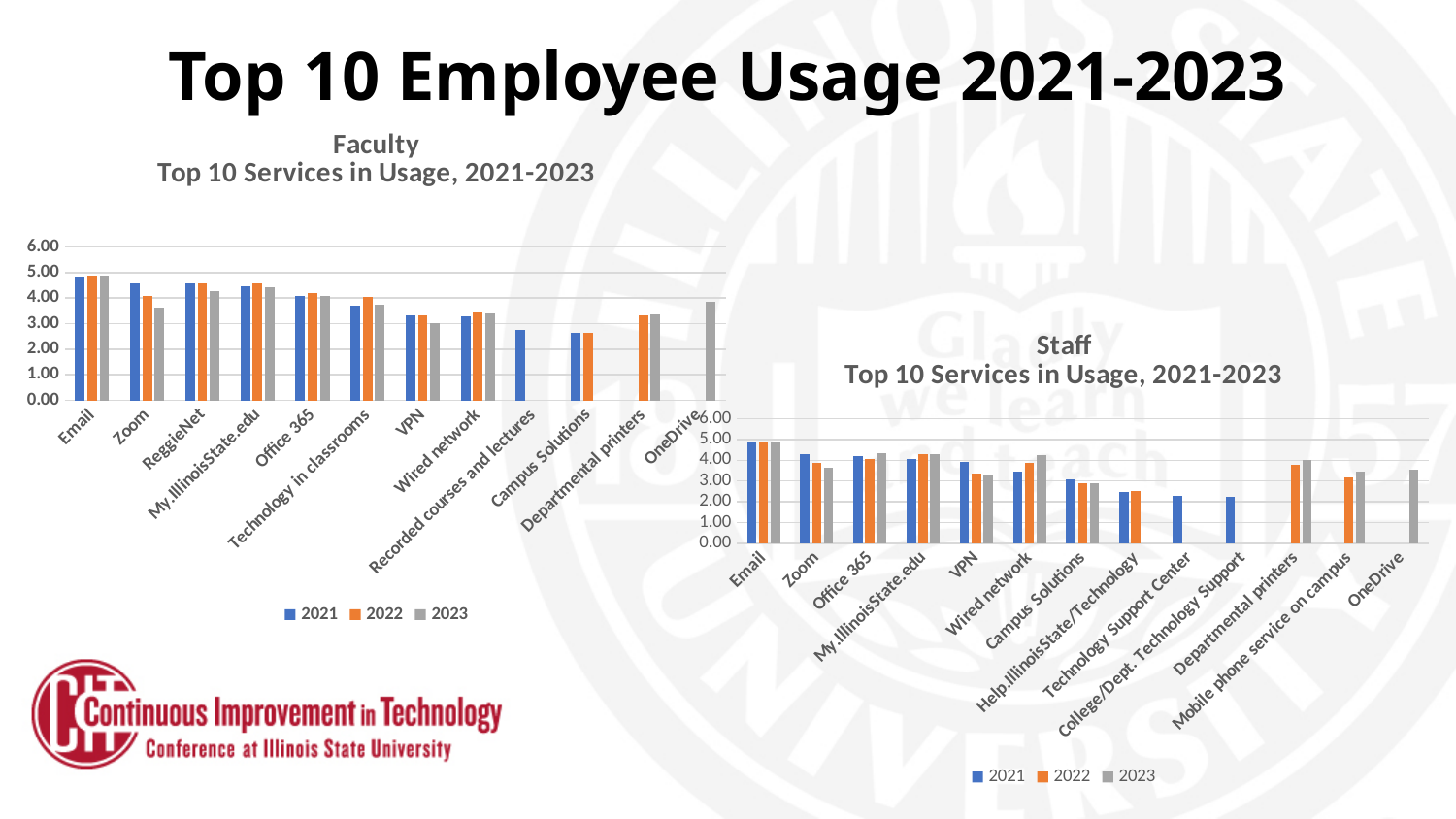
In the Faculty Top 10 Services in Usage chart, is the 2021 value for Recorded courses and lectures greater or less than 3.00? less In the Faculty Top 10 Services in Usage chart, do the values for Zoom rise or fall from 2021 to 2023? fall How many categories are shown on the x axis of the Faculty Top 10 Services in Usage chart? 12 In the Staff Top 10 Services in Usage chart, which is larger for Zoom: the 2021 value or the 2023 value? 2021 What type of chart is the Faculty Top 10 Services in Usage chart? bar chart In the Staff Top 10 Services in Usage chart, is the 2021 value for Technology Support Center greater or less than 3.00? less How many categories are shown on the x axis of the Staff Top 10 Services in Usage chart? 13 In the Staff Top 10 Services in Usage chart, is the 2021 value for Email greater or less than 4.00? greater In the Faculty Top 10 Services in Usage chart, which category has the highest 2021 value? Email How many series does the legend of the Staff Top 10 Services in Usage chart list? 3 In the Staff Top 10 Services in Usage chart, which category has the highest 2022 value? Email